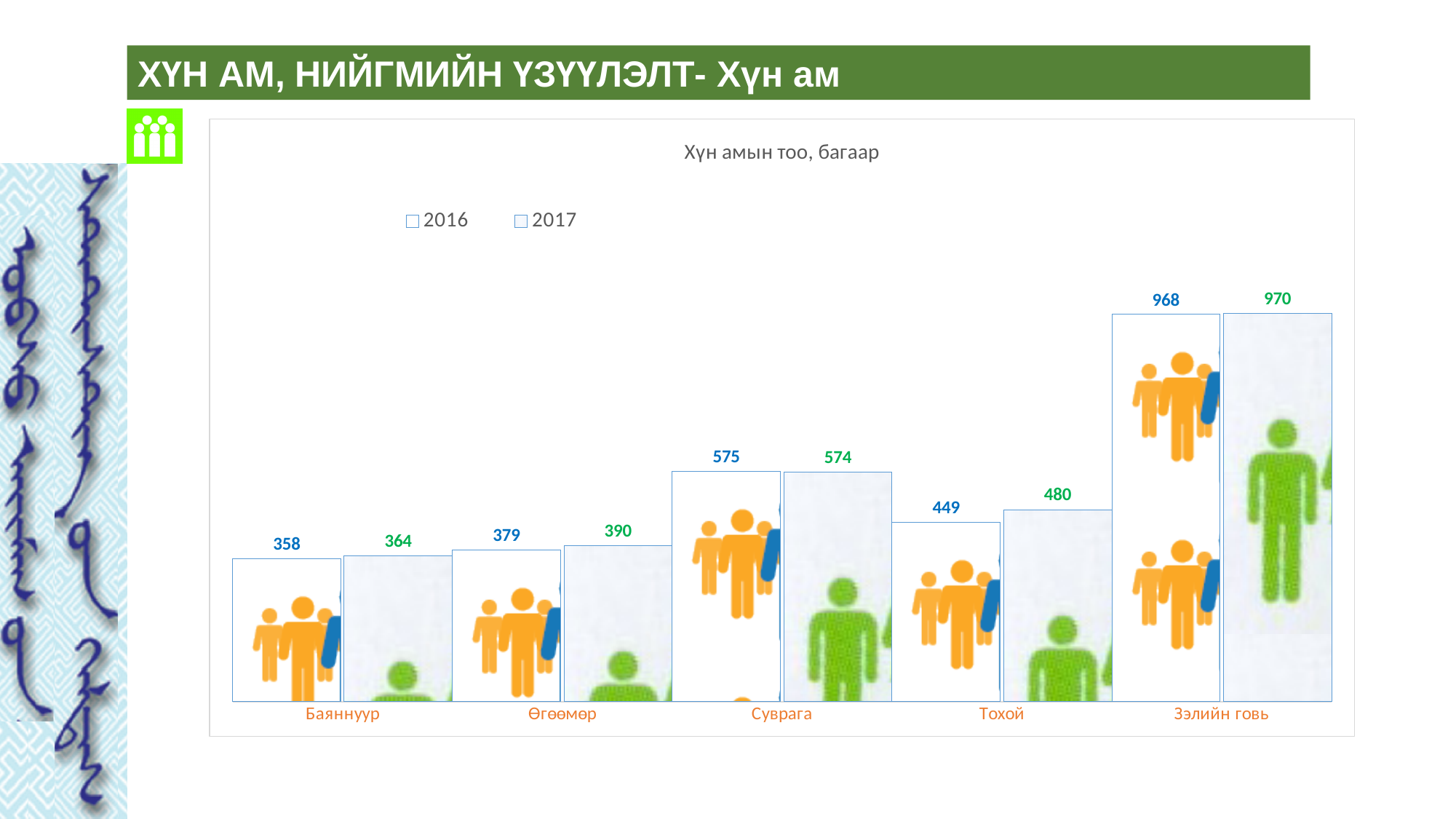
How many series does the legend list? 2 What is the 2016 value for Суврага? 575 What is the 2017 value for Өгөөмөр? 390 What is the difference between the 2016 values for Зэлийн говь and Суврага? 393 Which is larger for Суврага: the 2016 value or the 2017 value? 2016 Which category has the highest 2017 value? Зэлийн говь How many categories are shown on the x axis? 5 What is the 2016 value for Баяннуур? 358 What type of chart is shown? Bar chart What is the difference between the 2017 and 2016 values for Тохой? 31 What is the 2017 value for Тохой? 480 Which category has the lowest 2016 value? Баяннуур